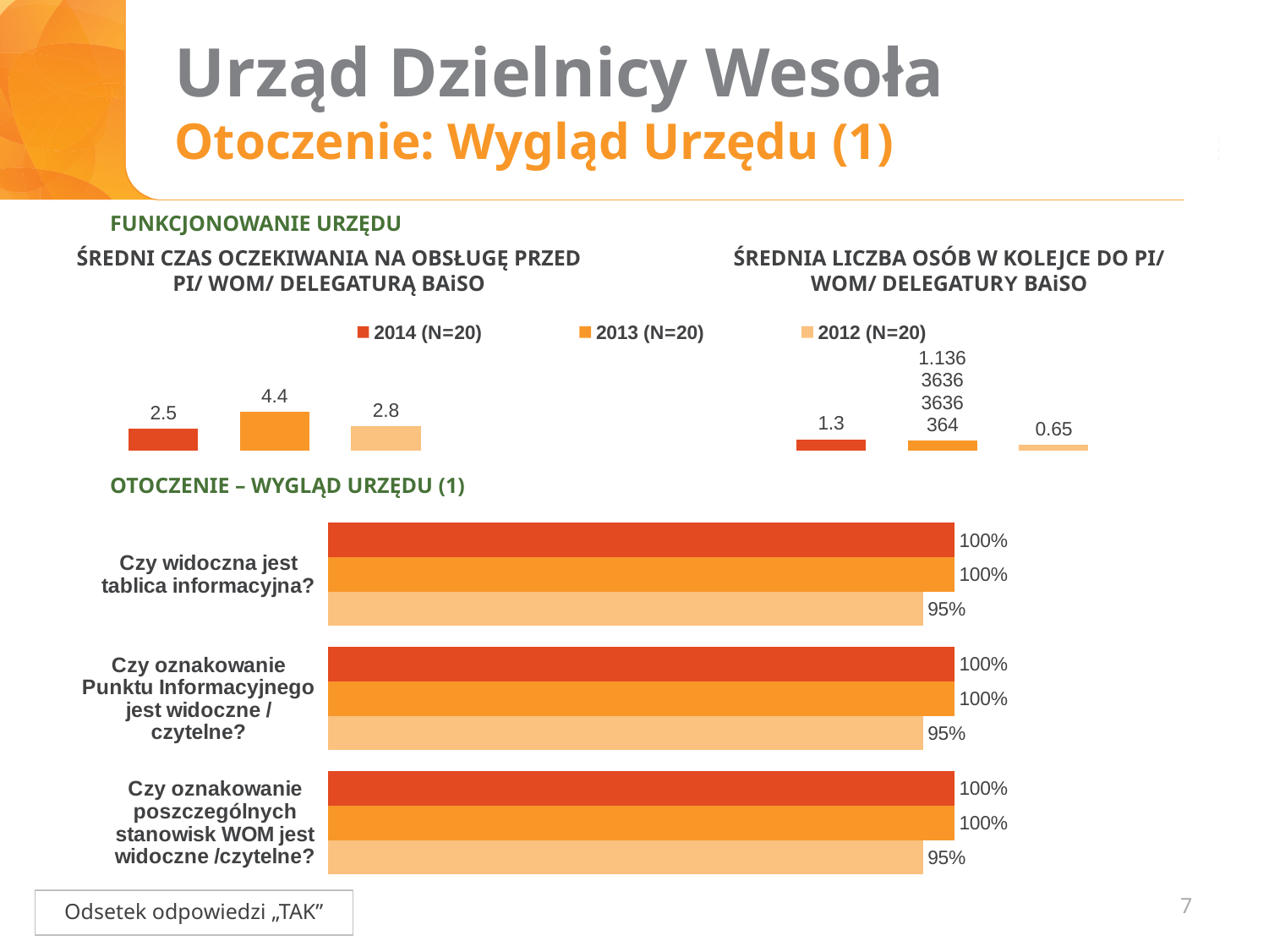
In the chart 'ŚREDNI CZAS OCZEKIWANIA NA OBSŁUGĘ PRZED PI/ WOM/ DELEGATURĄ BAiSO', which year has the highest value? 2013 (N=20) What kind of chart is the bottom chart 'OTOCZENIE – WYGLĄD URZĘDU (1)'? Bar chart In the chart 'ŚREDNIA LICZBA OSÓB W KOLEJCE DO PI/ WOM/ DELEGATURY BAiSO', what is the value for 2012 (N=20)? 0.65 In the chart 'ŚREDNIA LICZBA OSÓB W KOLEJCE DO PI/ WOM/ DELEGATURY BAiSO', what is the value for 2014 (N=20)? 1.3 In the bottom chart 'OTOCZENIE – WYGLĄD URZĘDU (1)', what is the 2014 value for 'Czy oznakowanie poszczególnych stanowisk WOM jest widoczne /czytelne?'? 100% How many series does the legend above the top charts list? 3 In the chart 'ŚREDNI CZAS OCZEKIWANIA NA OBSŁUGĘ PRZED PI/ WOM/ DELEGATURĄ BAiSO', what is the value for 2013 (N=20)? 4.4 In the chart 'ŚREDNIA LICZBA OSÓB W KOLEJCE DO PI/ WOM/ DELEGATURY BAiSO', which is larger, the value for 2014 or the value for 2012? 2014 In the bottom chart 'OTOCZENIE – WYGLĄD URZĘDU (1)', what is the 2012 value for 'Czy widoczna jest tablica informacyjna?'? 95% In the chart 'ŚREDNIA LICZBA OSÓB W KOLEJCE DO PI/ WOM/ DELEGATURY BAiSO', which year has the lowest value? 2012 (N=20) In the chart 'ŚREDNI CZAS OCZEKIWANIA NA OBSŁUGĘ PRZED PI/ WOM/ DELEGATURĄ BAiSO', what is the difference between the 2013 and 2014 values? 1.9 In the chart 'ŚREDNI CZAS OCZEKIWANIA NA OBSŁUGĘ PRZED PI/ WOM/ DELEGATURĄ BAiSO', what is the value for 2014 (N=20)? 2.5